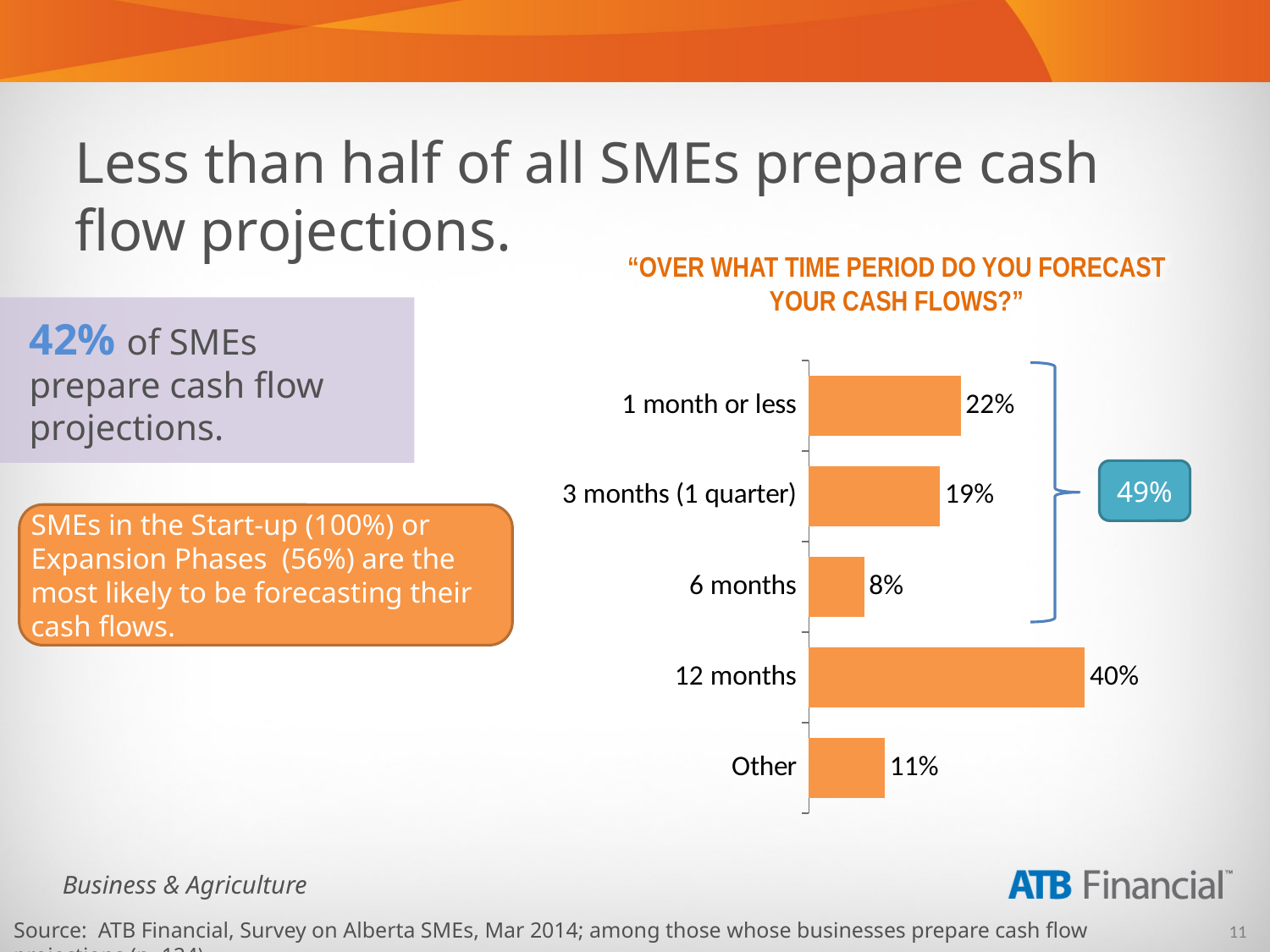
What combined percentage does the bracket beside the first three bars indicate? 49% Which time period has the highest percentage? 12 months Which time period has the lowest percentage? 6 months What percentage of SMEs forecast their cash flows over 12 months? 40% What is the title of the chart? "Over what time period do you forecast your cash flows?" Which is larger, the value for '3 months (1 quarter)' or the value for 'Other'? 3 months (1 quarter) What type of chart is shown on the slide? Bar chart How many categories are shown in the chart? 5 What is the value for 'Other'? 11% What is the value for '6 months'? 8% What is the difference between the values for '12 months' and '1 month or less'? 18% What is the value for '1 month or less'? 22%